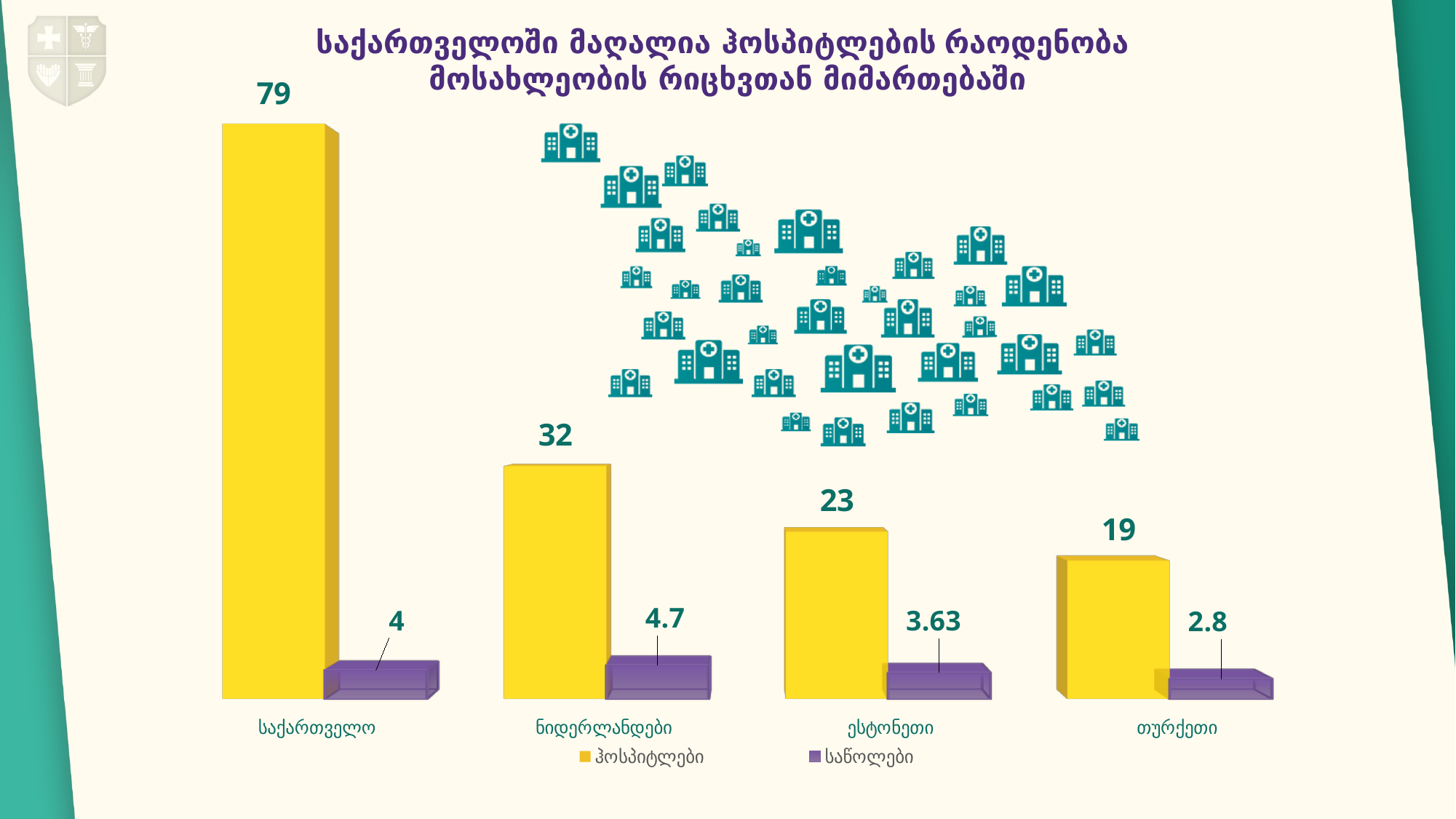
What is the difference between the ჰოსპიტლები values for საქართველო and ნიდერლანდები? 47 How many categories are shown on the x axis? 4 Do the ჰოსპიტლები values rise or fall from left to right along the x axis? Fall What is the value of the საწოლები (purple) bar for ნიდერლანდები? 4.7 What is the value of the საწოლები bar for თურქეთი? 2.8 What kind of chart is shown on the slide? Bar chart How many series does the legend list? 2 Which category has the lowest საწოლები value? თურქეთი What is the value of the ჰოსპიტლები bar for ესტონეთი? 23 Which category has the highest ჰოსპიტლები value? საქართველო Which is larger: the საწოლები value for საქართველო or for ნიდერლანდები? ნიდერლანდები What is the value of the ჰოსპიტლები (yellow) bar for საქართველო? 79